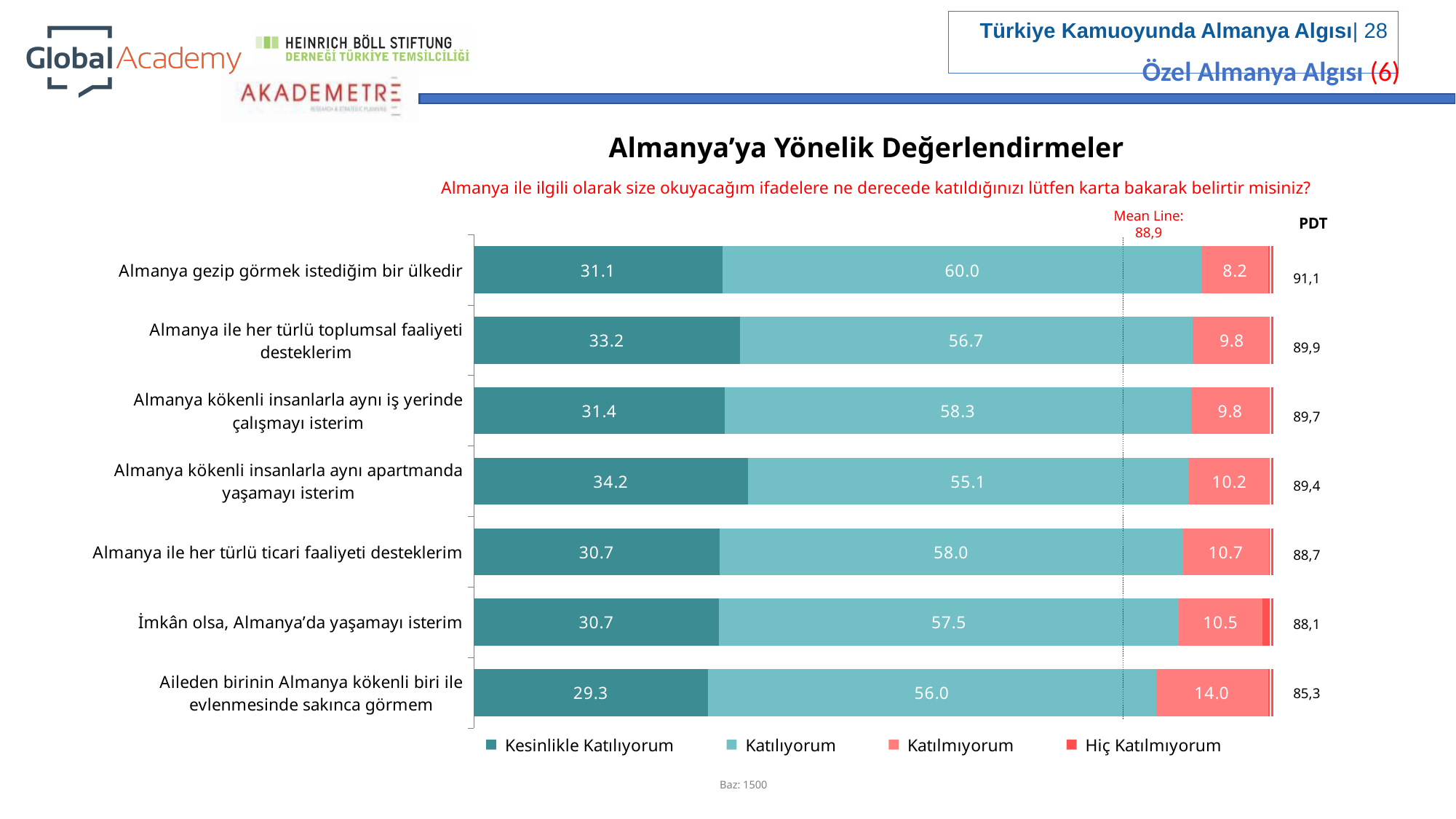
What value is given for the Mean Line on the chart? 88,9 How many series does the legend list? 4 Which statement has the highest 'Katılmıyorum' value? Aileden birinin Almanya kökenli biri ile evlenmesinde sakınca görmem How many statements are shown in the chart? 7 What is the 'Katılıyorum' value for 'Aileden birinin Almanya kökenli biri ile evlenmesinde sakınca görmem'? 56.0 Which statement has the highest 'Kesinlikle Katılıyorum' value? Almanya kökenli insanlarla aynı apartmanda yaşamayı isterim What is the 'Katılmıyorum' value for 'İmkân olsa, Almanya'da yaşamayı isterim'? 10.5 What kind of chart is shown on the slide? Stacked bar chart What is the 'Kesinlikle Katılıyorum' value for 'Almanya gezip görmek istediğim bir ülkedir'? 31.1 Which has a larger 'Kesinlikle Katılıyorum' value: 'Almanya ile her türlü toplumsal faaliyeti desteklerim' or 'Almanya ile her türlü ticari faaliyeti desteklerim'? Almanya ile her türlü toplumsal faaliyeti desteklerim What is the difference between the 'Katılıyorum' values for 'Almanya gezip görmek istediğim bir ülkedir' and 'Aileden birinin Almanya kökenli biri ile evlenmesinde sakınca görmem'? 4.0 Which statement has the lowest 'Katılıyorum' value? Almanya kökenli insanlarla aynı apartmanda yaşamayı isterim